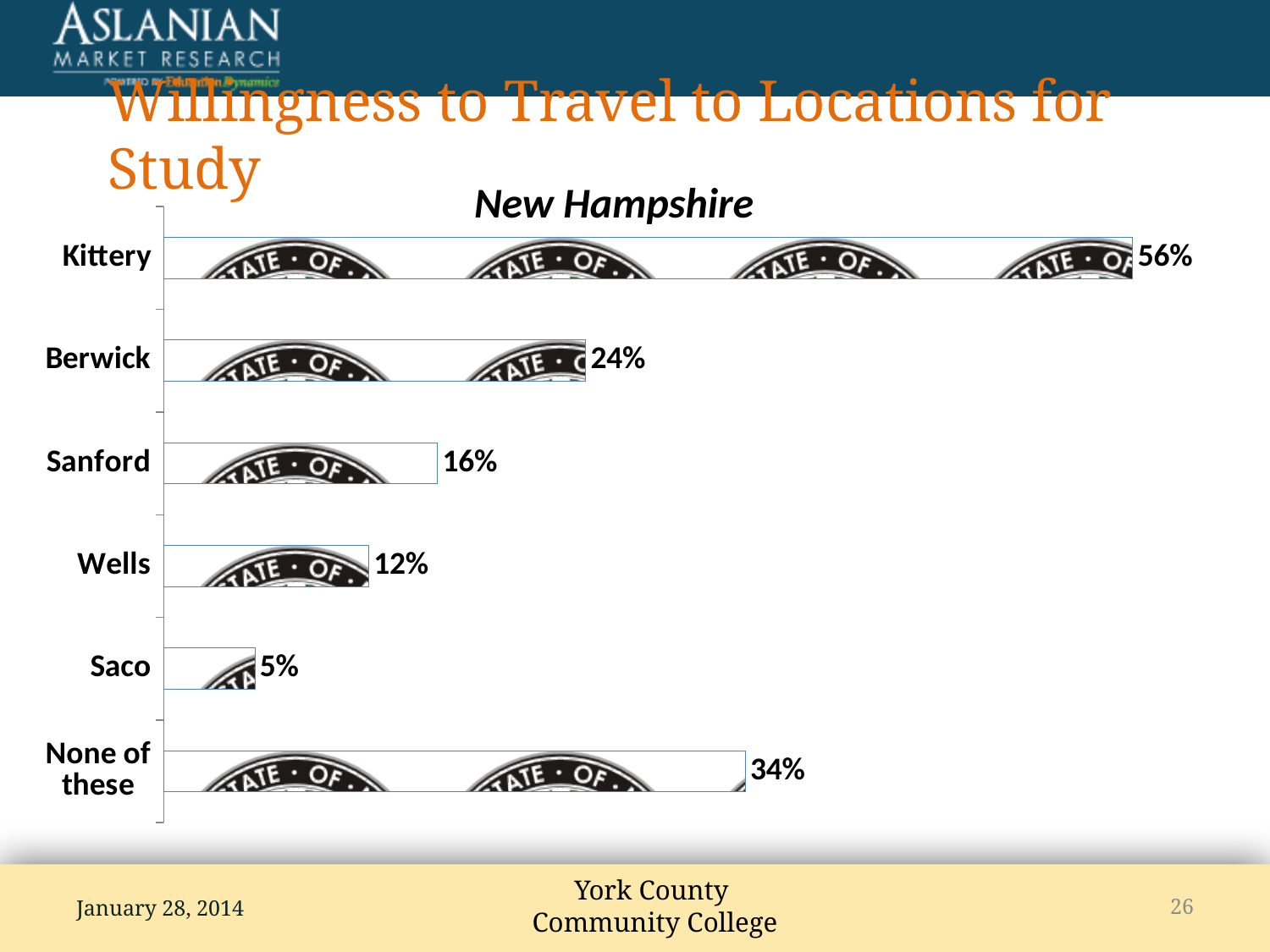
What is the value for Sanford? 16% What is the value for Berwick? 24% What is the title of the chart? New Hampshire Which is larger, the value for Berwick or the value for None of these? None of these Which category has the highest value? Kittery What is the difference between the values for Kittery and Berwick? 32% Which category has the lowest value? Saco What is the value for Wells? 12% What is the value for None of these? 34% What kind of chart is shown on the slide? Bar chart What is the value for Kittery? 56% How many categories are shown in the chart? 6